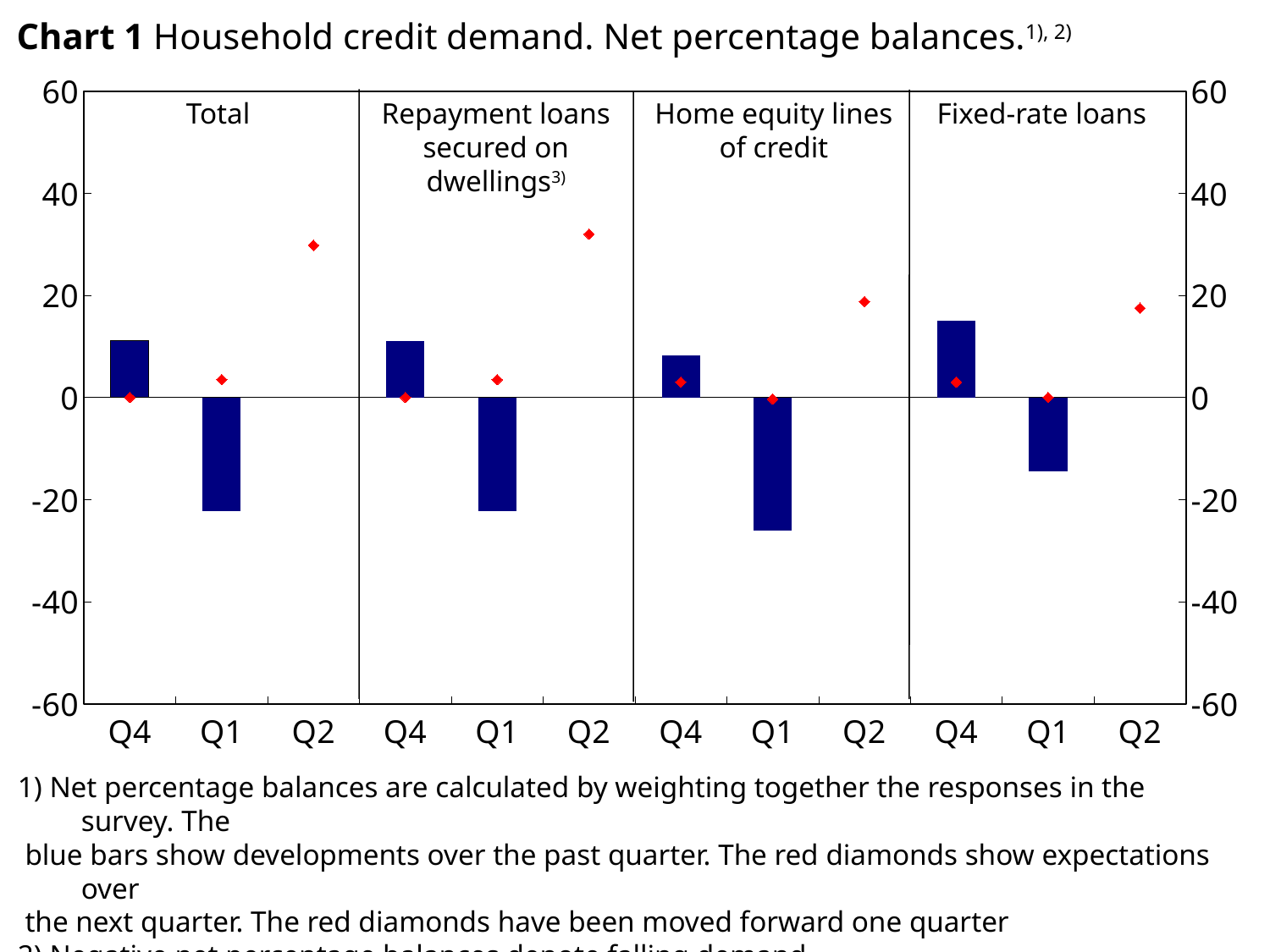
In the Total panel, is the Q1 bar greater or less than -20? less In the Home equity lines of credit panel, is the Q1 bar greater or less than -20? less According to the footnote, what do the red diamonds show? Expectations over the next quarter How many panels (loan categories) does Chart 1 show? 4 In the Total panel, is the Q2 red diamond greater or less than 20? greater Which panel has the lowest Q1 bar? Home equity lines of credit How many quarters are shown on the x axis of each panel? 3 What kind of chart is Chart 1? bar chart with red diamond markers Which is larger: the Q4 bar in the Fixed-rate loans panel or the Q4 bar in the Total panel? Fixed-rate loans